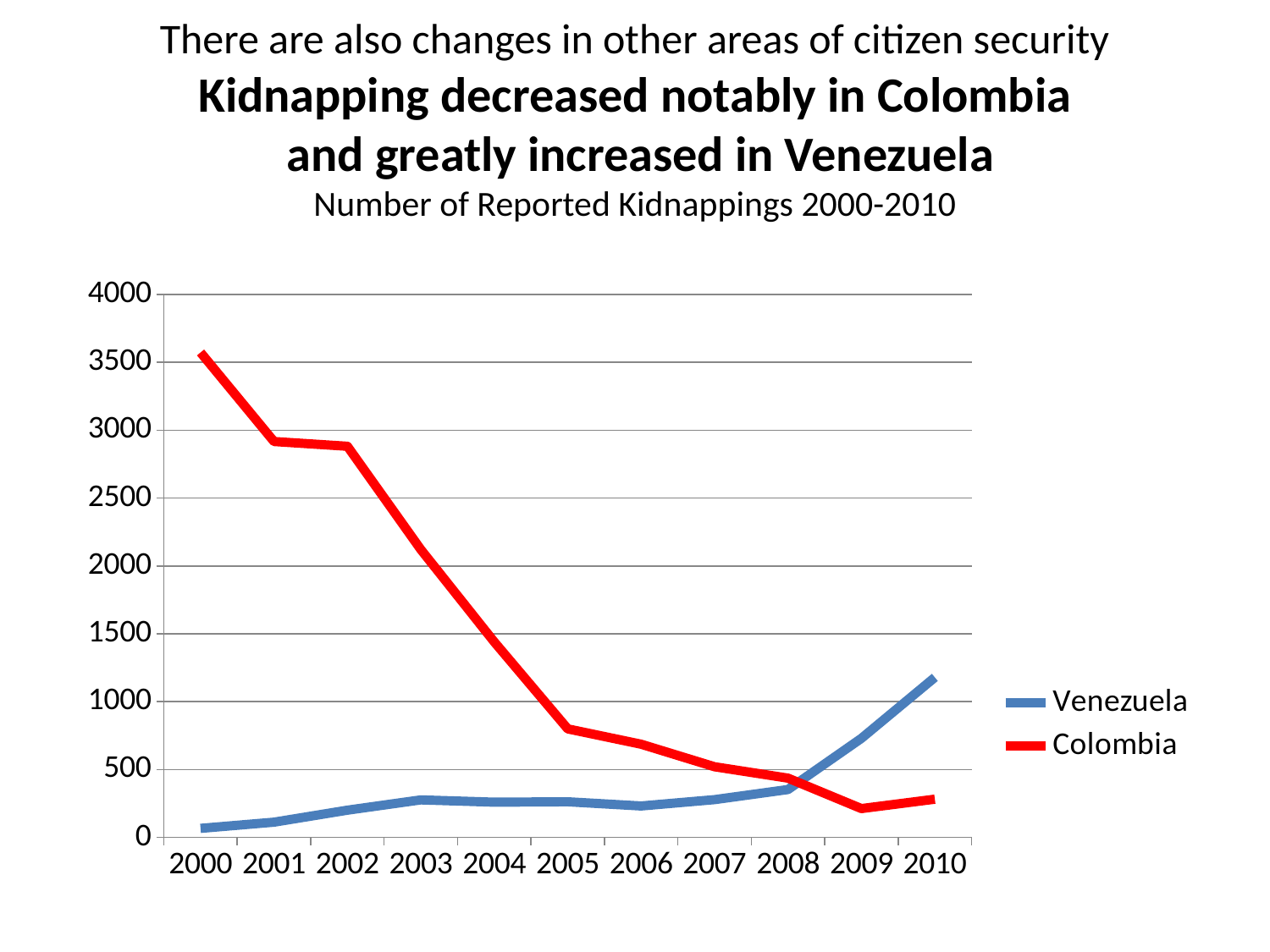
How many years are plotted along the x axis? 11 Is the value for Colombia in 2005 greater or less than 1000? less Is the value for Venezuela in 2010 greater or less than 1000? greater What kind of chart is shown on the slide? line chart Do the values for Colombia rise or fall from 2000 to 2010? fall How many series does the legend list? 2 Do the values for Venezuela rise or fall from 2000 to 2010? rise Which series has the larger value in 2000, Venezuela or Colombia? Colombia In which year is the value for Venezuela highest? 2010 In which year is the value for Colombia highest? 2000 Which colour is used for the Colombia line? red In which year is the value for Colombia lowest? 2009